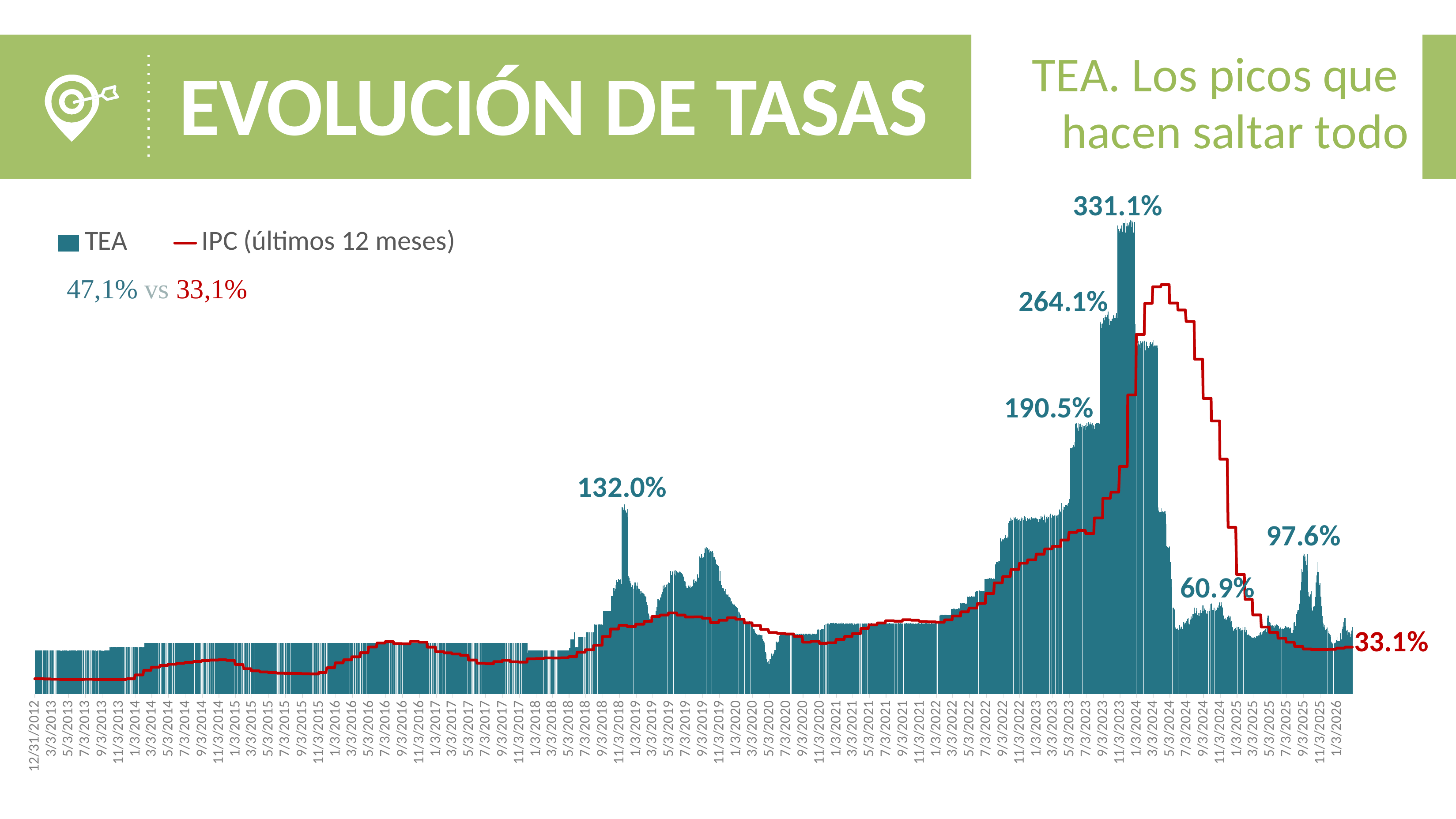
Does the IPC line rise or fall between early 2024 and early 2026? fall What TEA value is labelled at the peak in late 2025? 97.6% What is the difference between the labelled TEA values of 97.6% and 60.9%? 36.7 percentage points What is the difference between the labelled TEA peaks of 331.1% and 264.1%? 67.0 percentage points What is the highest TEA value labelled on the chart? 331.1% Which labelled TEA value is larger, 190.5% or 132.0%? 190.5% What are the two legend entries of the chart? TEA and IPC (últimos 12 meses) What is the final IPC (últimos 12 meses) value labelled at the right end of the red line? 33.1% What TEA value is labelled at the spike around late 2018? 132.0% How many series does the legend list? 2 What is the lowest TEA value labelled on the chart? 60.9% How many TEA data labels are printed on the chart? 6